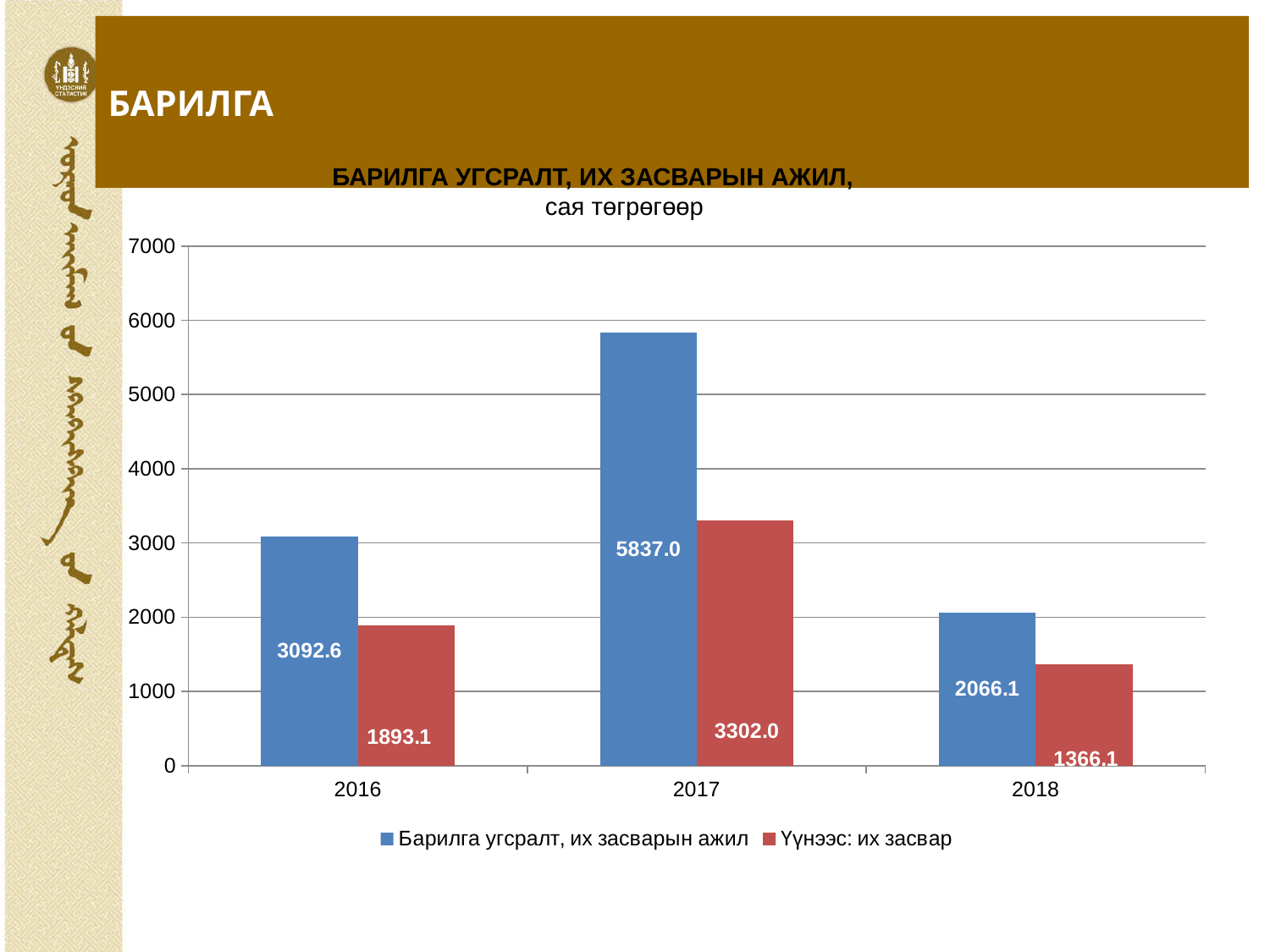
How many series does the legend list? 2 How many years are shown on the x axis? 3 In which year is "Барилга угсралт, их засварын ажил" highest? 2017 Is the value for "Барилга угсралт, их засварын ажил" in 2018 greater or less than 3000? less What kind of chart is shown on the slide? bar chart What is the difference between "Барилга угсралт, их засварын ажил" and "Үүнээс: их засвар" in 2017? 2535.0 What is the value for "Үүнээс: их засвар" in 2016? 1893.1 In which year is "Үүнээс: их засвар" lowest? 2018 What is the value for "Барилга угсралт, их засварын ажил" in 2017? 5837.0 Which is larger: "Үүнээс: их засвар" in 2016 or in 2018? 2016 What is the value for "Үүнээс: их засвар" in 2018? 1366.1 What is the difference between the "Барилга угсралт, их засварын ажил" values for 2016 and 2018? 1026.5